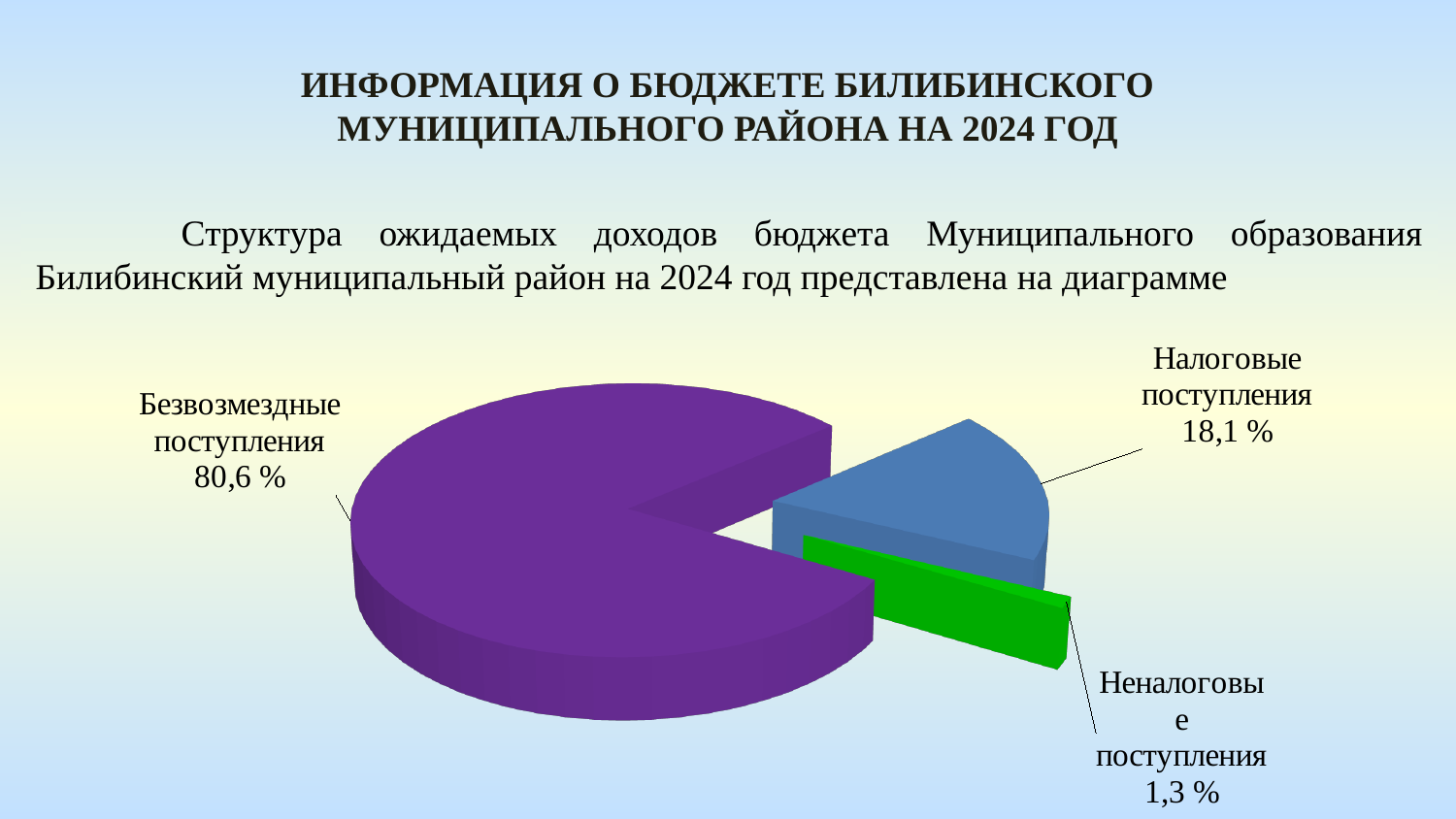
Which category has the smallest share of the pie? Неналоговые поступления What kind of chart is shown on the slide? pie chart What share of the pie is Неналоговые поступления? 1,3 % What is the difference in percentage points between Безвозмездные поступления and Налоговые поступления? 62,5 What is the difference in percentage points between Налоговые поступления and Неналоговые поступления? 16,8 How many slices does the pie chart have? 3 What share of the pie is Налоговые поступления? 18,1 % Which is larger, the share for Налоговые поступления or the share for Неналоговые поступления? Налоговые поступления What colour is the slice for Неналоговые поступления? green What share of the pie is Безвозмездные поступления? 80,6 % Which category has the largest share of the pie? Безвозмездные поступления What colour is the slice for Безвозмездные поступления? purple